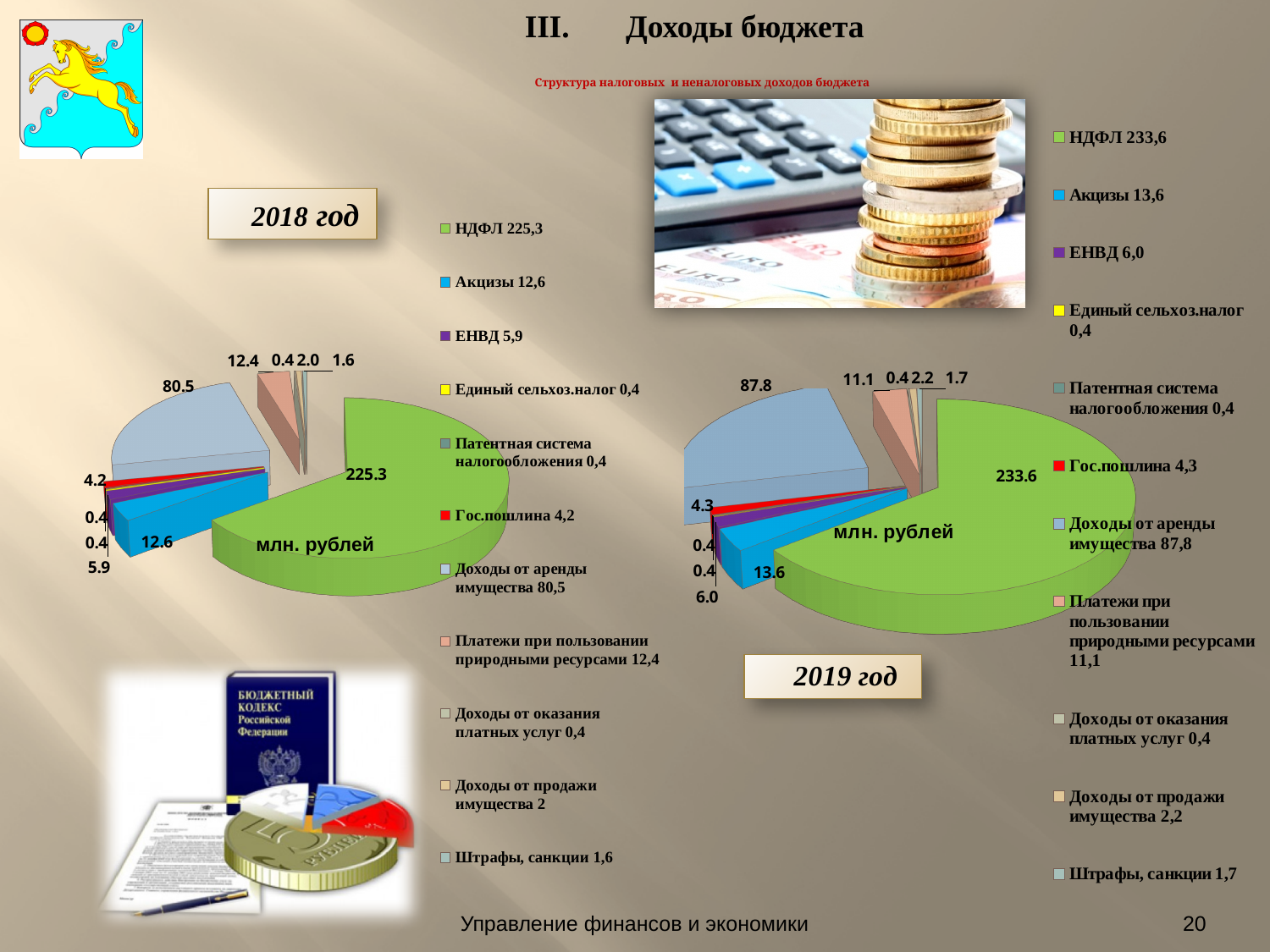
What unit is shown in the centre of both pie charts? млн. рублей What type of chart is used for the 2018 год data? pie chart What is the difference between the НДФЛ value in the 2019 год chart and the НДФЛ value in the 2018 год chart? 8.3 In the 2019 год chart, which category has the largest value? НДФЛ In the 2019 год chart, what is the value for Доходы от аренды имущества? 87.8 In the 2018 год chart, what is the value for НДФЛ? 225.3 In the 2018 год chart, which category has the second largest value? Доходы от аренды имущества How many categories does the legend of the 2019 год chart list? 11 In the 2019 год chart, what is the value for Гос.пошлина? 4.3 In the 2018 год chart, what is the value for Платежи при пользовании природными ресурсами? 12.4 In the 2018 год chart, which is larger: Акцизы or ЕНВД? Акцизы In the 2019 год chart, what is the value for Акцизы? 13.6